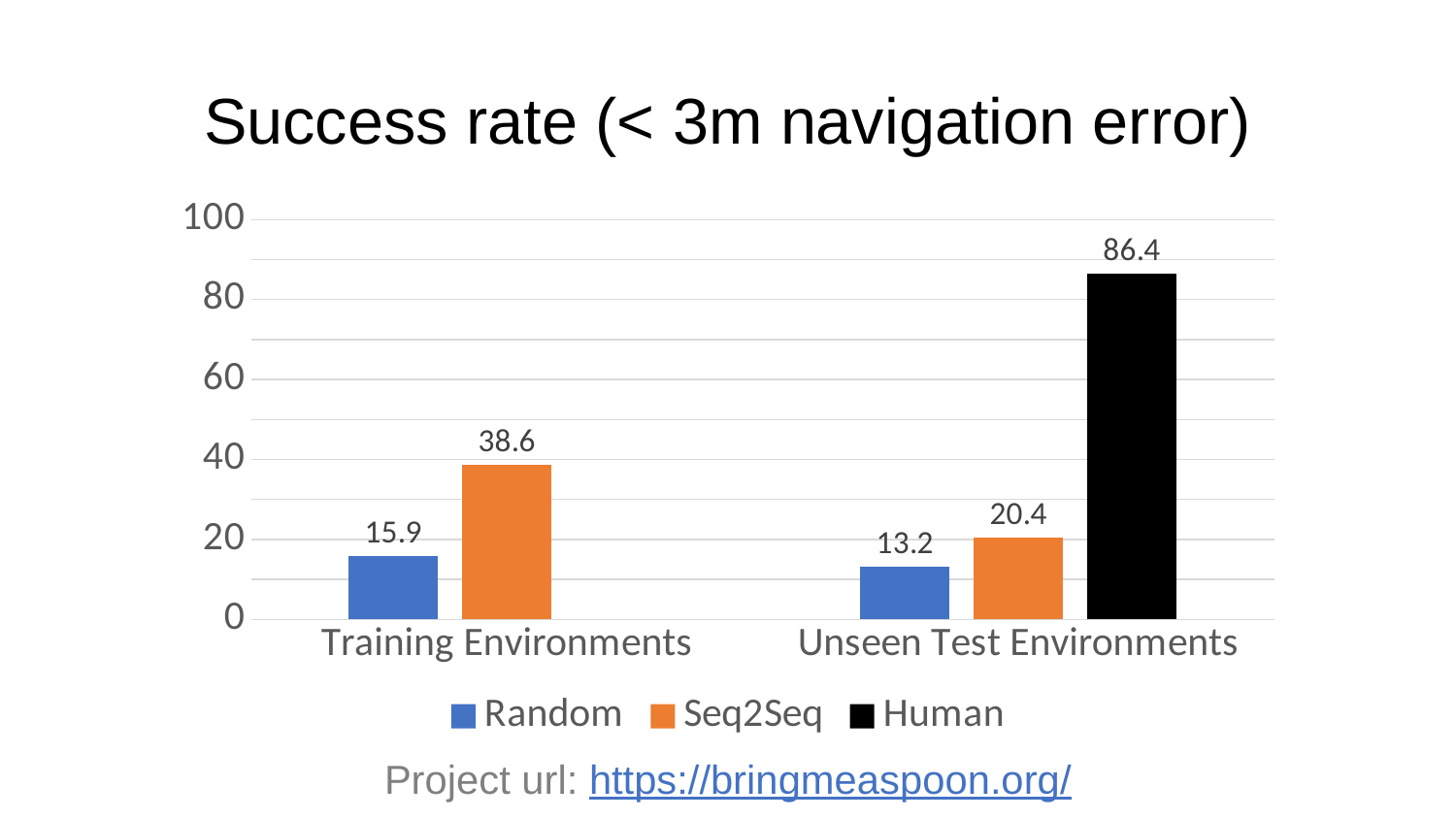
What is the success rate for Random in Unseen Test Environments? 13.2 How many series does the legend list? 3 Is the value for Human in Unseen Test Environments greater or less than 80? greater Which is larger: Random in Training Environments or Random in Unseen Test Environments? Random in Training Environments What is the success rate for Seq2Seq in Training Environments? 38.6 What is the difference between the Seq2Seq values in Training Environments and Unseen Test Environments? 18.2 Which series has the highest value in Unseen Test Environments? Human What is the success rate for Human in Unseen Test Environments? 86.4 What is the title of the chart? Success rate (< 3m navigation error) What kind of chart is shown on the slide? bar chart How many categories are shown on the x axis? 2 Which series has the lowest value in Unseen Test Environments? Random